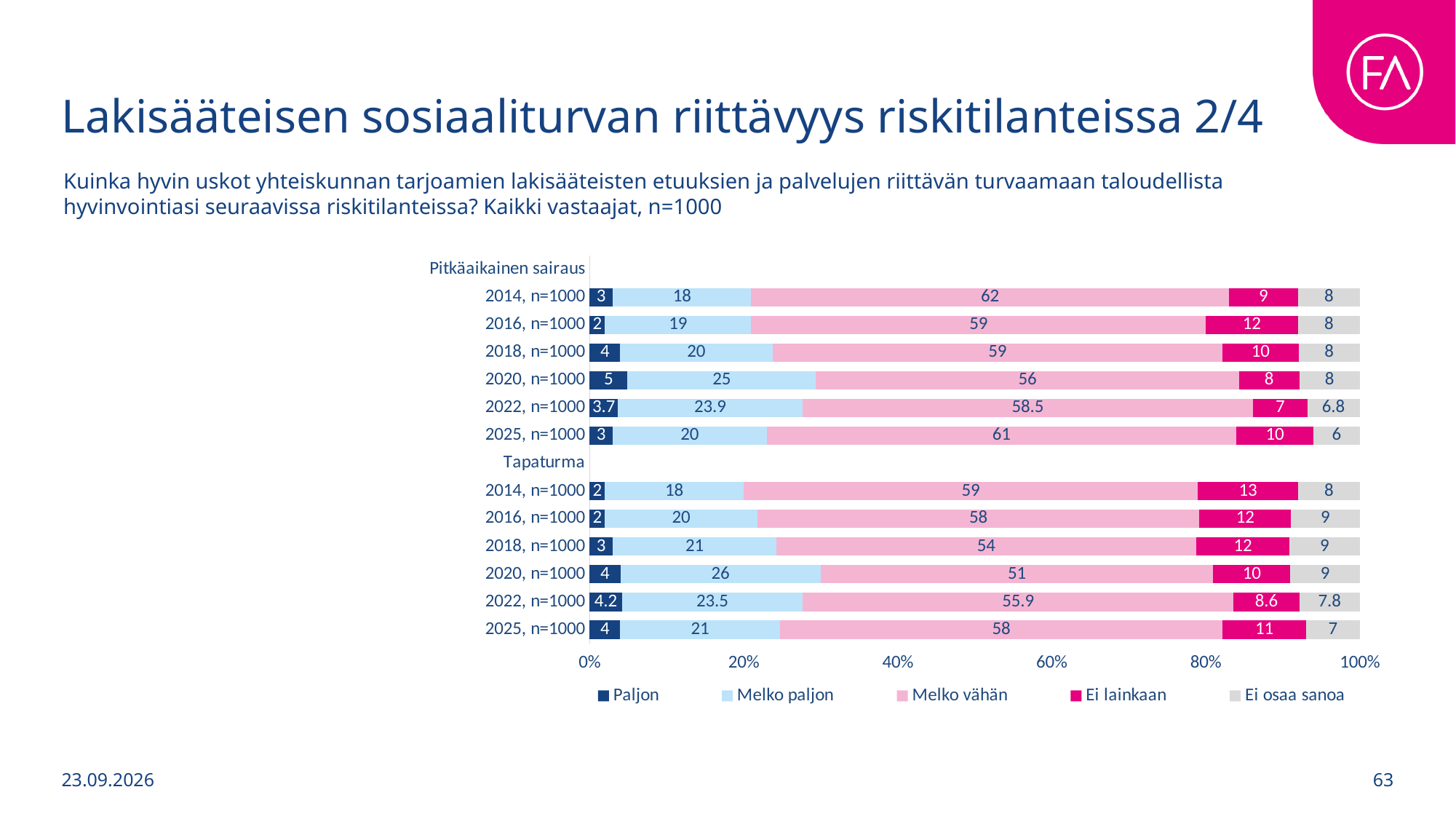
What is the value of "Melko vähän" for Pitkäaikainen sairaus, 2014, n=1000? 62 Within the Pitkäaikainen sairaus group, which year has the highest "Melko vähän" value? 2014, n=1000 What is the value of "Paljon" for Pitkäaikainen sairaus, 2022, n=1000? 3.7 How many series does the legend list? 5 What is the value of "Ei lainkaan" for Tapaturma, 2022, n=1000? 8.6 What is the value of "Melko paljon" for Tapaturma, 2020, n=1000? 26 What kind of chart is shown on the slide? Stacked bar chart What is the total of the stacked bar for Tapaturma, 2022, n=1000? 100 How many bars (year rows) are plotted in the chart in total? 12 What is the difference between the "Ei lainkaan" values for Pitkäaikainen sairaus 2016 and 2014? 3 Within the Tapaturma group, which year has the lowest "Melko vähän" value? 2020, n=1000 Which has the larger "Melko vähän" value for 2025: Pitkäaikainen sairaus or Tapaturma? Pitkäaikainen sairaus